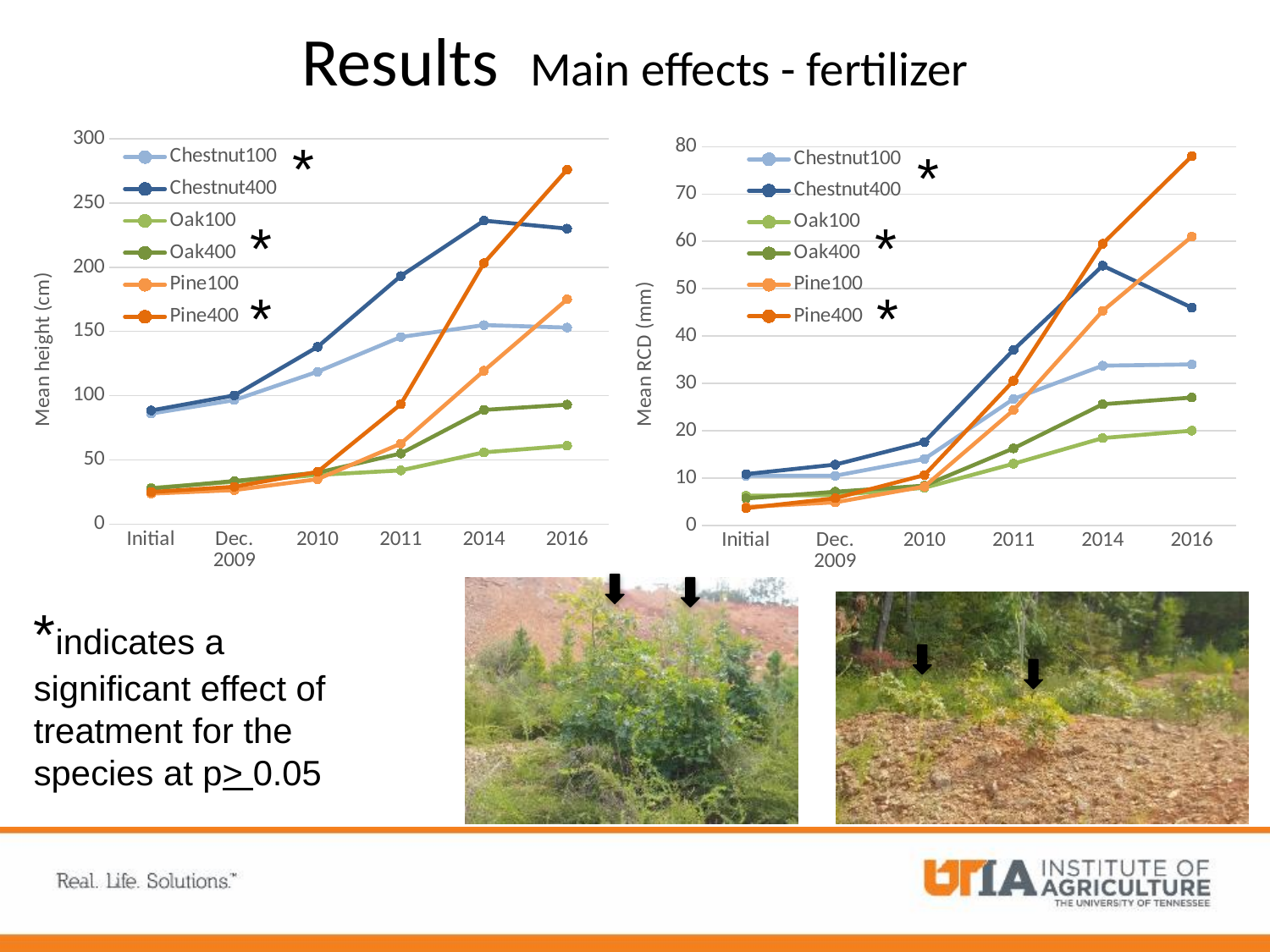
What kind of chart is the left chart (Mean height)? line chart In the left chart (Mean height), is the value for Pine400 in 2016 greater or less than 250? greater In the left chart (Mean height), which is larger in 2016: Chestnut400 or Pine100? Chestnut400 How many time points are shown on the x axis of the left chart (Mean height)? 6 In the right chart (Mean RCD), which series has the lowest value in 2016? Oak100 How many series does the legend of the right chart (Mean RCD) list? 6 What is the y-axis label of the right chart? Mean RCD (mm) In the right chart (Mean RCD), does the Chestnut400 series rise or fall from 2014 to 2016? fall In the right chart (Mean RCD), which series has the highest value in 2016? Pine400 In the left chart (Mean height), which series has the highest value in 2016? Pine400 In the right chart (Mean RCD), is the value for Pine400 in 2016 greater or less than 70? greater In the left chart (Mean height), which series has the lowest value in 2016? Oak100